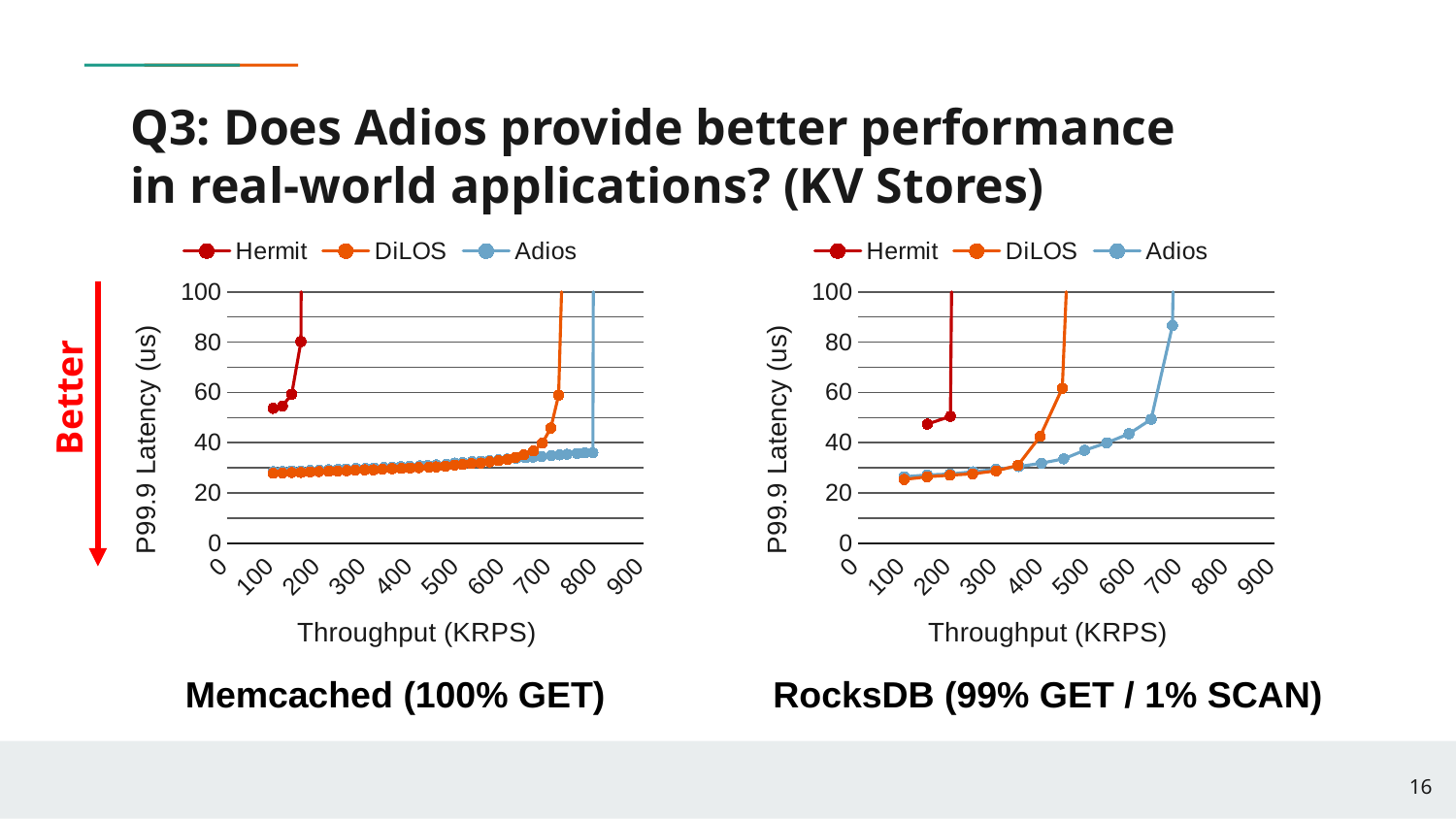
In the Memcached (100% GET) chart, is the Hermit latency at 100 KRPS greater or less than 40 us? greater In the RocksDB (99% GET / 1% SCAN) chart, which series has its latency spike at the lowest throughput? Hermit In the RocksDB (99% GET / 1% SCAN) chart, is the DiLOS latency at 100 KRPS greater or less than 40 us? less In the RocksDB (99% GET / 1% SCAN) chart, does the Adios latency rise or fall as throughput increases? rise In the Memcached (100% GET) chart, at 100 KRPS, which series has the higher latency, Hermit or Adios? Hermit In the Memcached (100% GET) chart, which series reaches the highest throughput before its latency spikes? Adios In the Memcached (100% GET) chart, is the Adios latency at 500 KRPS greater or less than 40 us? less What is the y-axis label of the RocksDB (99% GET / 1% SCAN) chart? P99.9 Latency (us) What kind of chart is the Memcached (100% GET) chart? line chart In the Memcached (100% GET) chart, which series are listed in the legend? Hermit, DiLOS, Adios How many series does the legend of the RocksDB (99% GET / 1% SCAN) chart list? 3